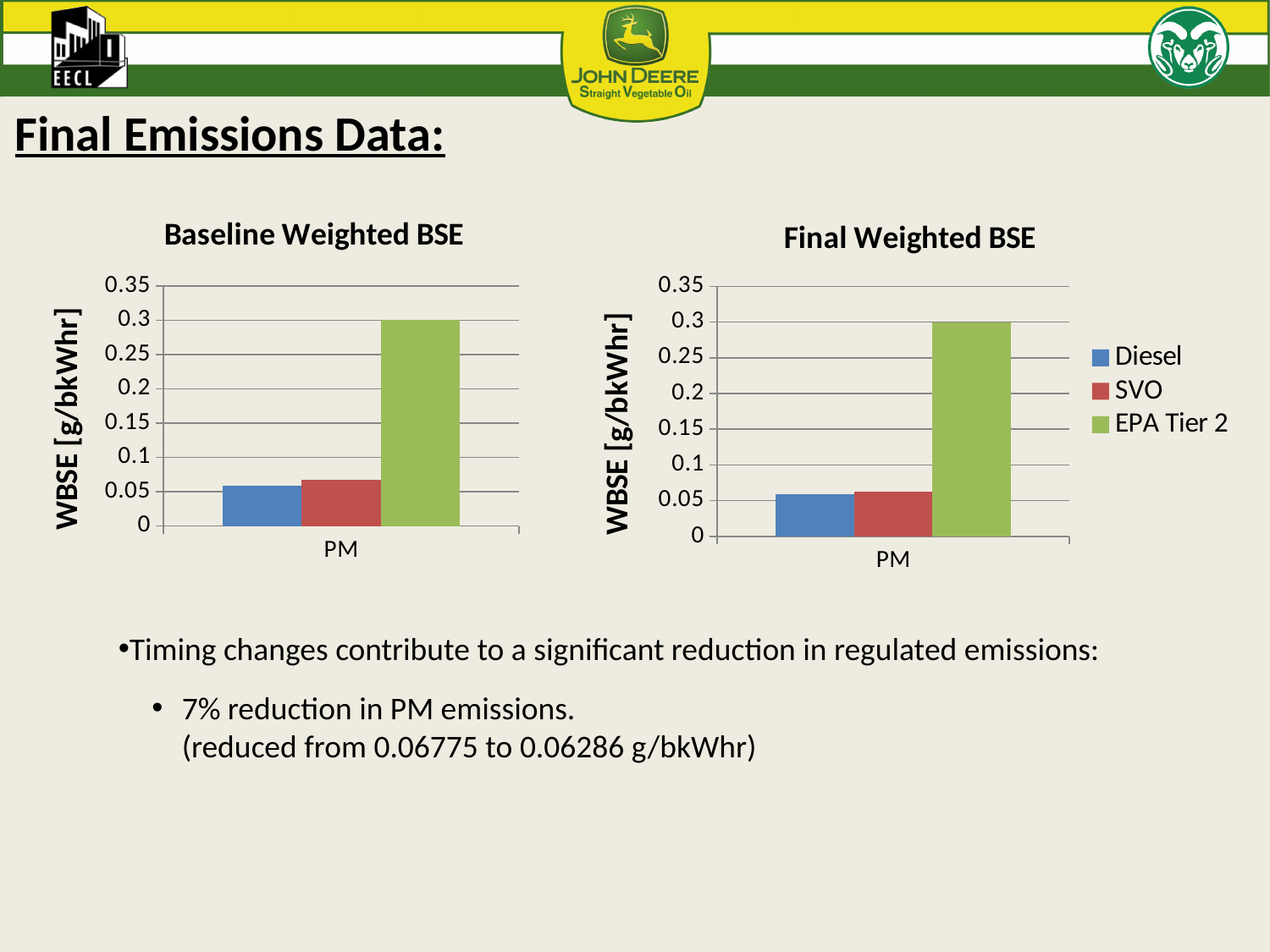
How many categories are shown on the x axis of the Baseline Weighted BSE chart? 1 In the Final Weighted BSE chart, which series has the highest value for PM? EPA Tier 2 In the Baseline Weighted BSE chart, which series has the highest value for PM? EPA Tier 2 In the Baseline Weighted BSE chart, is the value for SVO greater or less than 0.1? less In the Final Weighted BSE chart, is the value for Diesel greater or less than 0.1? less How many series does the legend of the Final Weighted BSE chart list? 3 In the Final Weighted BSE chart, which is larger, the value for EPA Tier 2 or the value for Diesel? EPA Tier 2 What kind of chart is the Baseline Weighted BSE chart? bar chart In the Final Weighted BSE chart, what is the value for EPA Tier 2? 0.3 What is the y-axis label of the Final Weighted BSE chart? WBSE [g/bkWhr] In the Baseline Weighted BSE chart, what is the value for EPA Tier 2? 0.3 In the Final Weighted BSE chart, what colour represents the EPA Tier 2 series? green